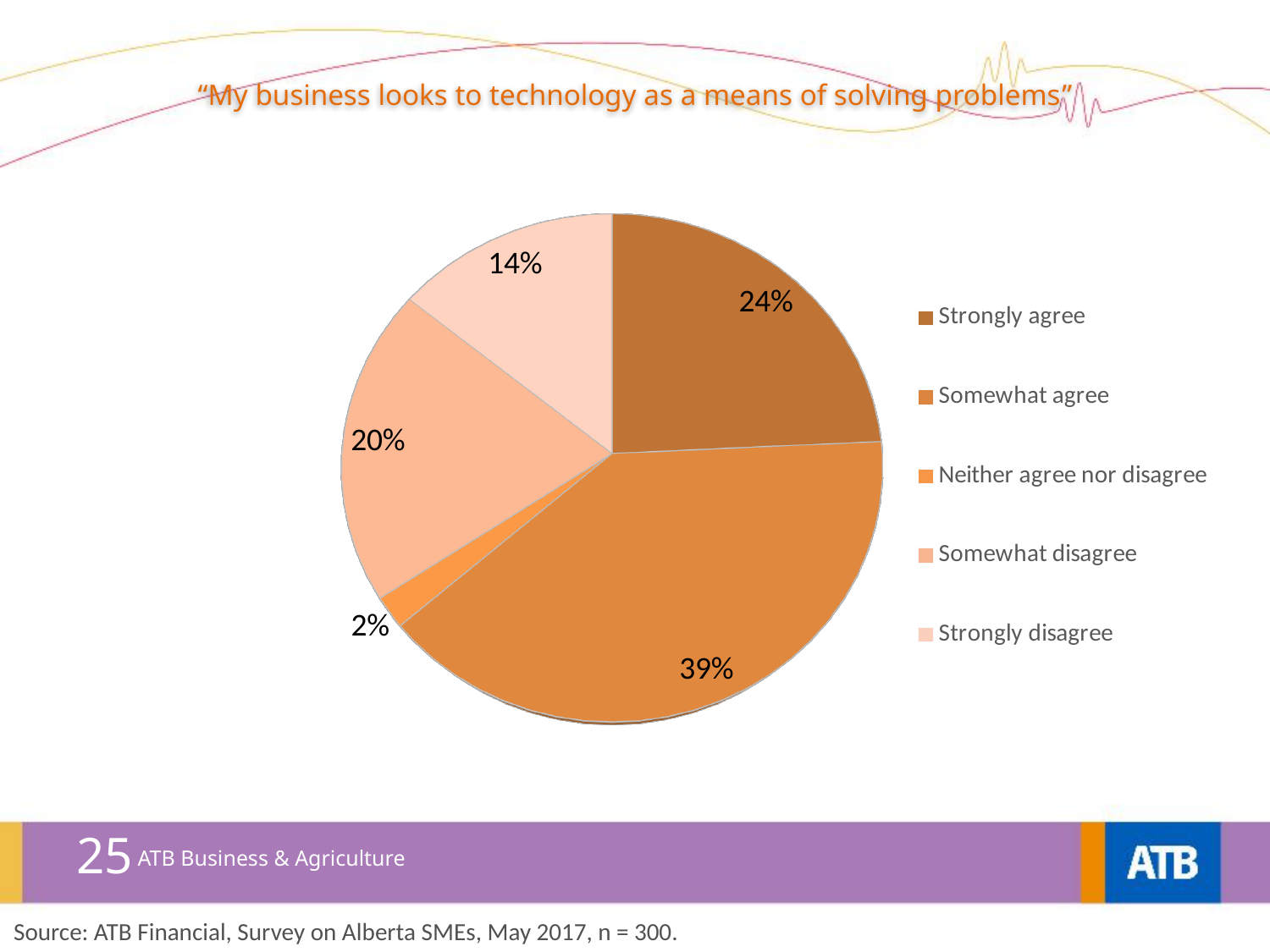
What type of chart is shown on the slide? Pie chart Which is larger: the share for "Somewhat disagree" or the share for "Strongly disagree"? Somewhat disagree What share of the pie is labelled for "Somewhat agree"? 39% What percentage of respondents strongly disagree? 14% What percentage of respondents somewhat disagree? 20% What percentage of respondents strongly agree that their business looks to technology as a means of solving problems? 24% Which response category has the smallest share of the pie? Neither agree nor disagree What percentage of respondents neither agree nor disagree? 2% How many slices does the pie chart have? 5 Which response category has the largest share of the pie? Somewhat agree How many percentage points larger is the "Somewhat agree" slice than the "Strongly agree" slice? 15 What is the title of the chart on the slide? "My business looks to technology as a means of solving problems"